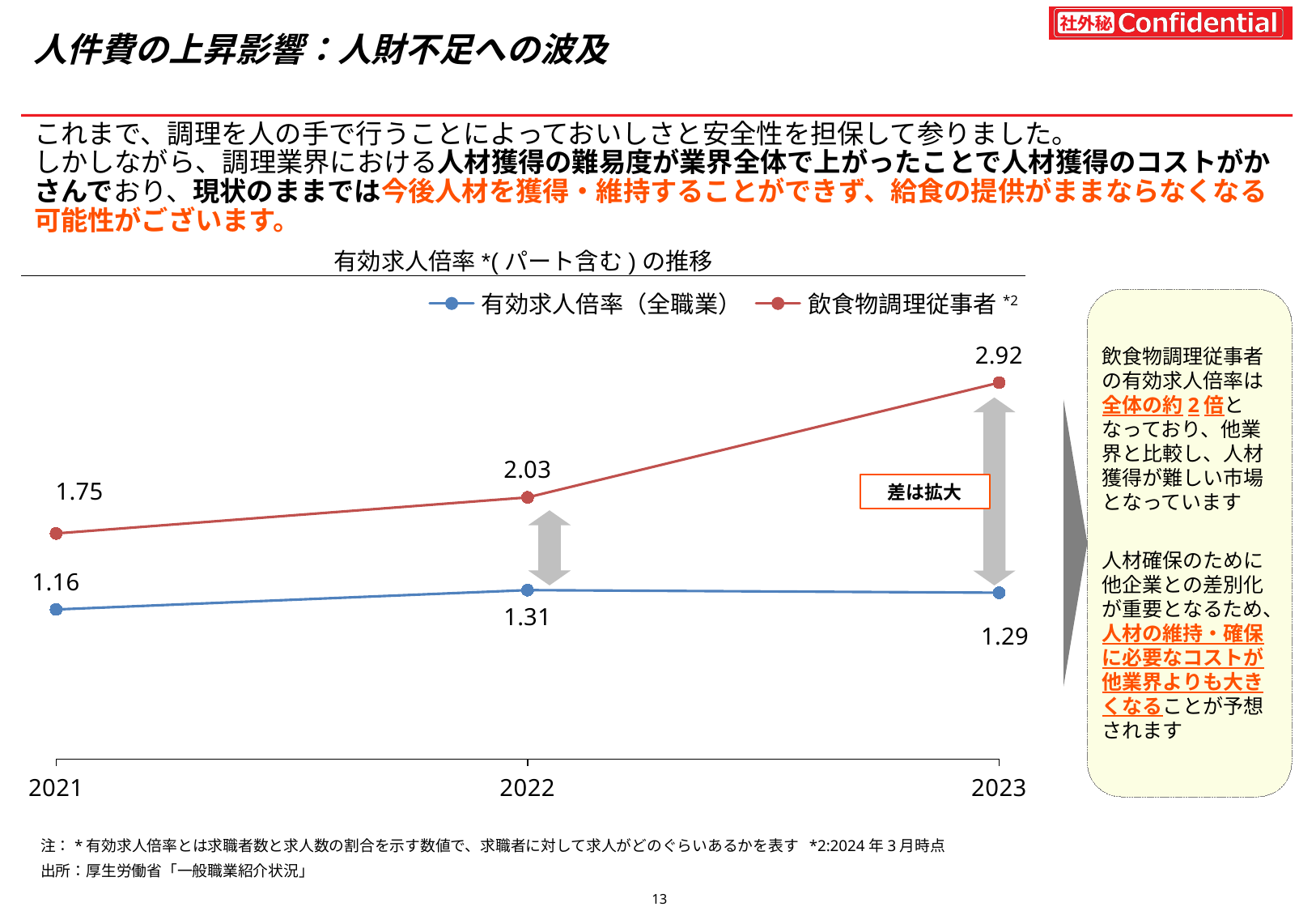
What kind of chart is shown on the slide? Line chart In which year is the value for 有効求人倍率（全職業） lowest? 2021 What is the difference between 飲食物調理従事者 and 有効求人倍率（全職業） in 2023? 1.63 What is the difference between the 2023 and 2021 values for 飲食物調理従事者? 1.17 What is the value for 有効求人倍率（全職業） in 2023? 1.29 How many series does the legend list? 2 What is the value for 有効求人倍率（全職業） in 2021? 1.16 In which year is the value for 飲食物調理従事者 highest? 2023 How many years are plotted on the x axis? 3 Which series has the larger value in 2022, 飲食物調理従事者 or 有効求人倍率（全職業）? 飲食物調理従事者 What is the value for 飲食物調理従事者 in 2022? 2.03 What is the value for 飲食物調理従事者 in 2023? 2.92